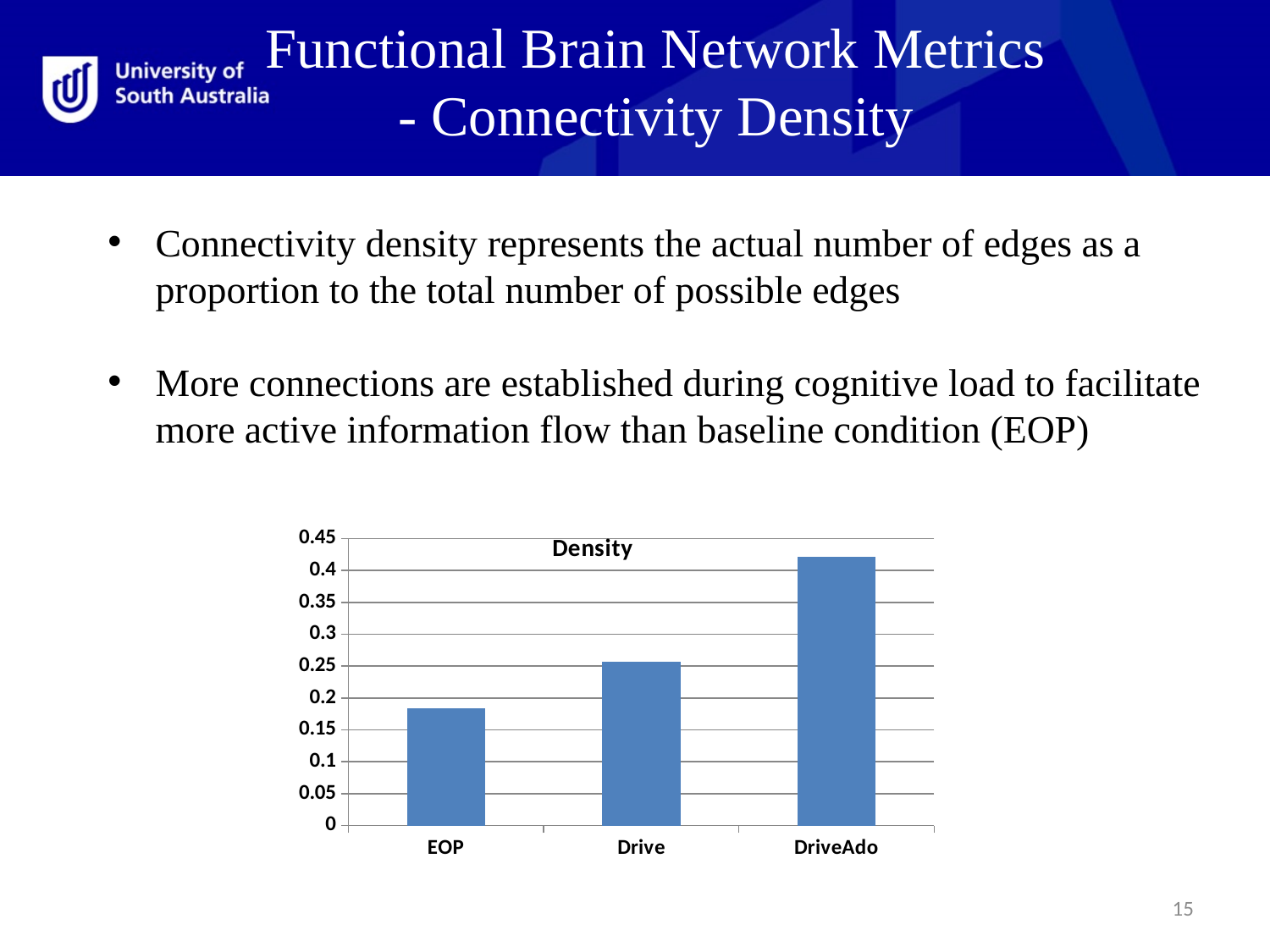
Which has a lower density, EOP or Drive? EOP Which category has the lowest density? EOP Is the density for Drive greater or less than 0.3? less What is the title of the chart? Density Which has a higher density, Drive or DriveAdo? DriveAdo What kind of chart is shown on the slide? bar chart Is the density for EOP greater or less than 0.2? less How many categories are shown on the x axis of the chart? 3 Which category has the highest density? DriveAdo Do the density values rise or fall from EOP to DriveAdo along the x axis? rise Is the density for DriveAdo greater or less than 0.4? greater